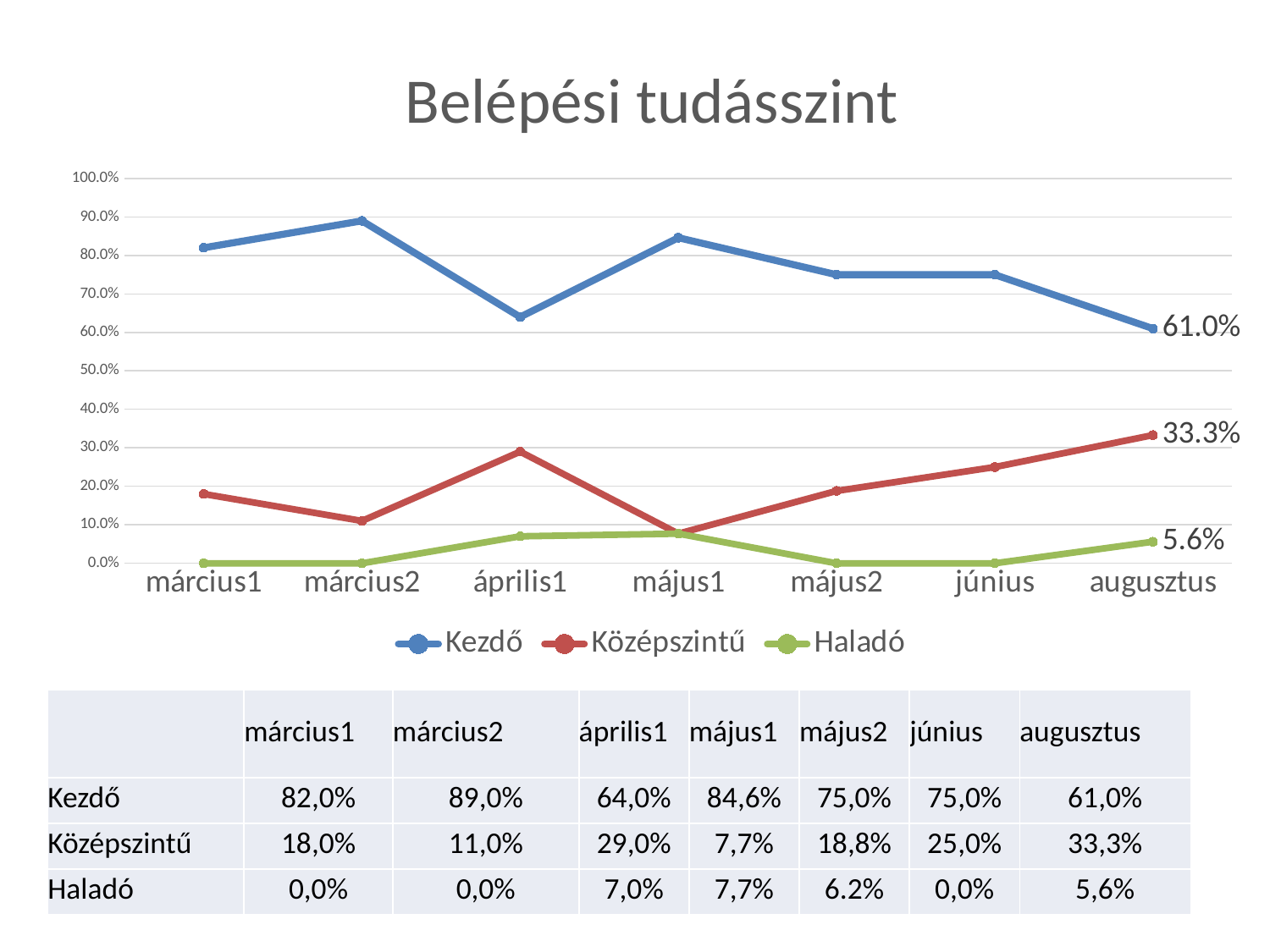
What is the value for Haladó at április1? 7,0% Does the Középszintű series rise or fall from május1 to augusztus? rise What is the value for Kezdő at augusztus? 61.0% At which category is the Kezdő series lowest? augusztus How many categories are plotted along the x axis? 7 Which is larger for Középszintű: the value at április1 or at május1? április1 At which category is the Középszintű series highest? augusztus At which category is the Kezdő series highest? március2 How many series does the legend list? 3 What is the value for Középszintű at június? 25,0% What is the difference between the Kezdő values at március2 and március1? 7,0% What kind of chart is shown on the slide? line chart